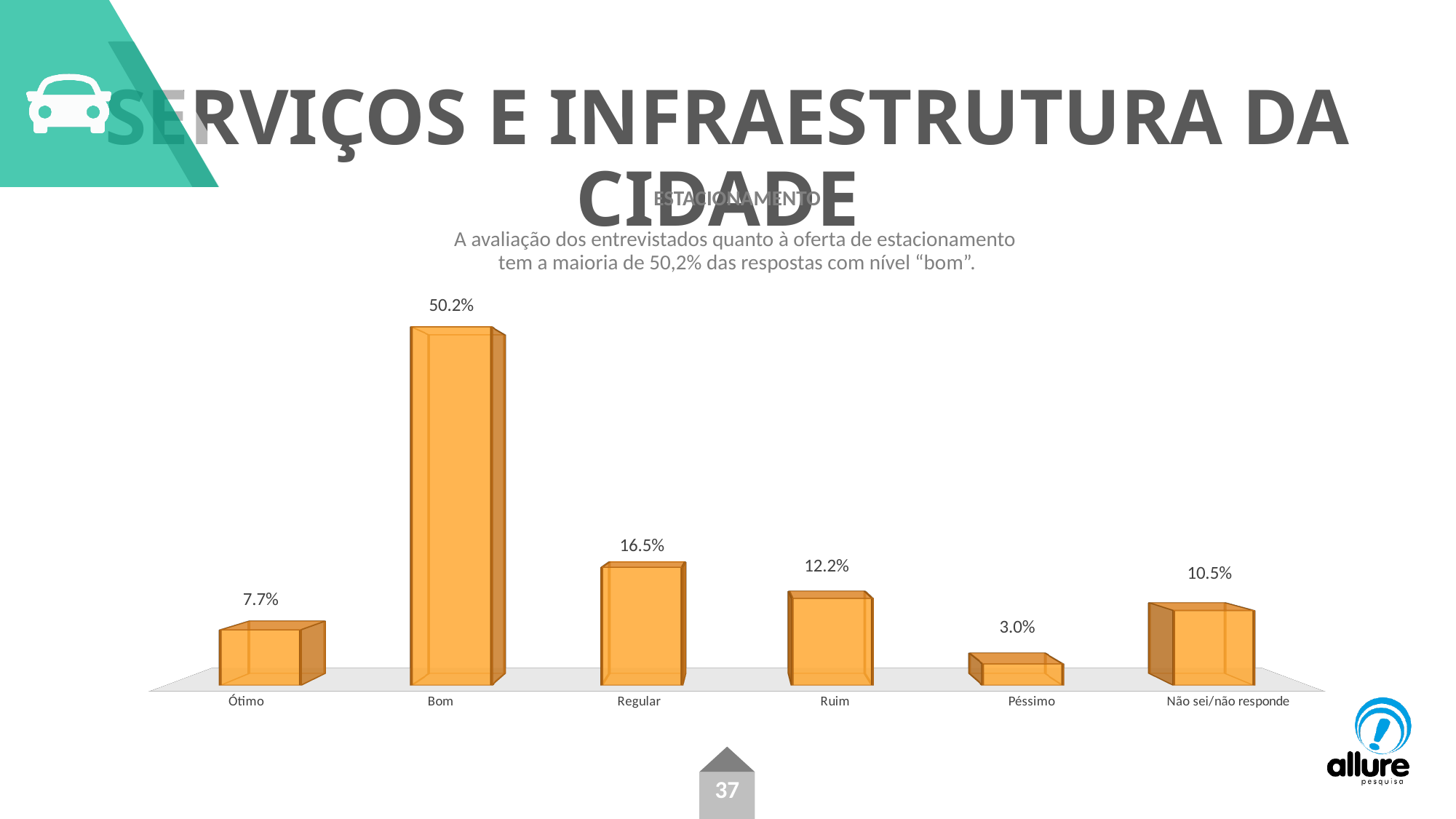
Which category has the lowest value? Péssimo What is the difference between the values for Bom and Regular? 33.7% How many categories are shown on the x axis? 6 What is the difference between the values for Ruim and Ótimo? 4.5% Which is larger, the value for Ruim or the value for Não sei/não responde? Ruim What is the value for Regular? 16.5% What is the value for Bom? 50.2% What kind of chart is shown on the slide? Bar chart What is the value for Não sei/não responde? 10.5% What colour are the bars in the chart? Orange Which category has the highest value? Bom What is the value for Péssimo? 3.0%